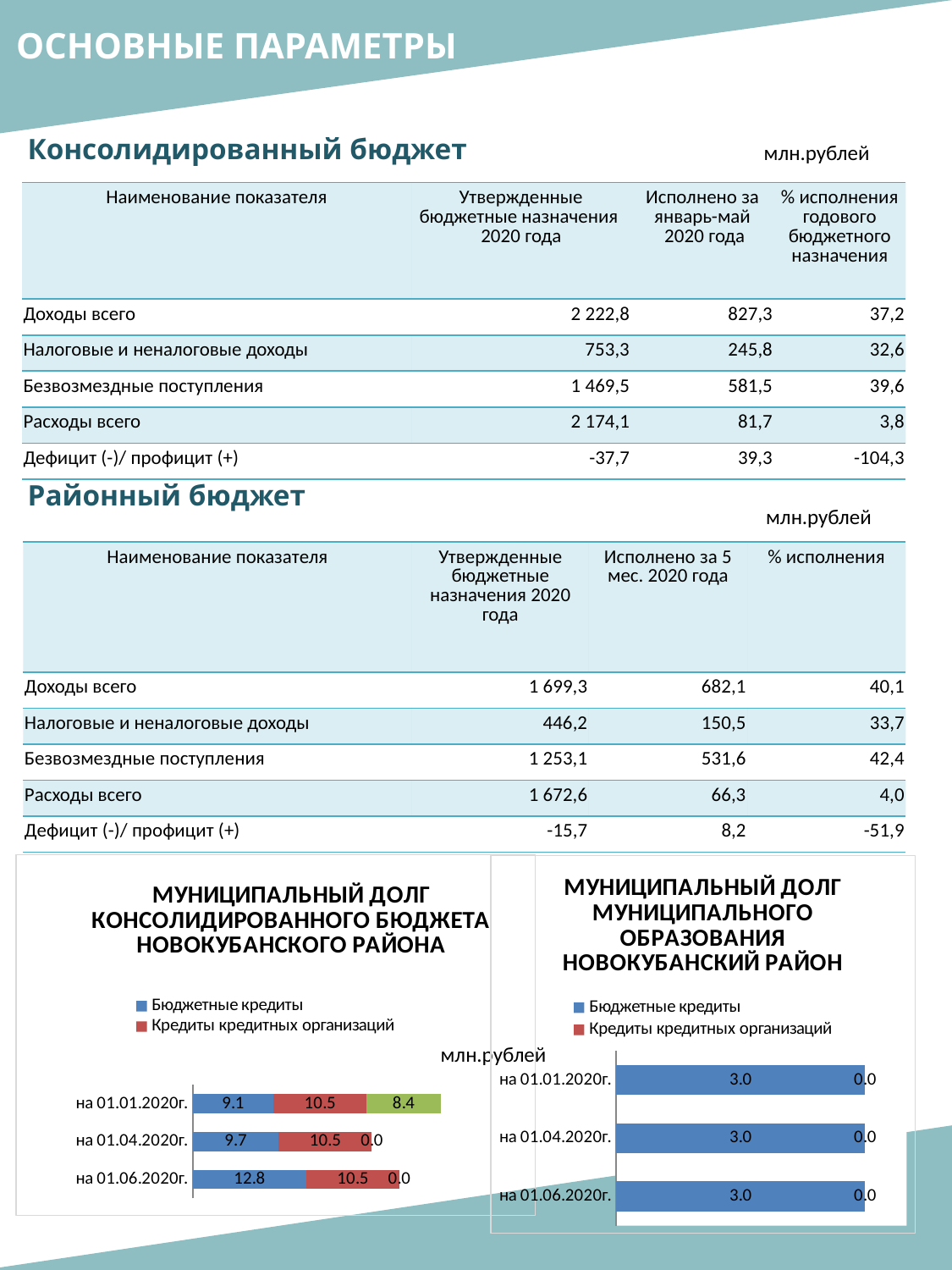
What kind of chart is the left chart titled 'МУНИЦИПАЛЬНЫЙ ДОЛГ КОНСОЛИДИРОВАННОГО БЮДЖЕТА НОВОКУБАНСКОГО РАЙОНА'? bar chart In the left chart (консолидированный бюджет), which is larger на 01.04.2020г.: Бюджетные кредиты or Кредиты кредитных организаций? Кредиты кредитных организаций In the right chart (муниципальное образование Новокубанский район), does the value of Бюджетные кредиты rise, fall or stay the same across the three dates? stays the same In the right chart (муниципальное образование Новокубанский район), what is the value of Кредиты кредитных организаций на 01.06.2020г.? 0.0 How many series does the legend of the left chart (консолидированный бюджет) list? 2 In the right chart (муниципальное образование Новокубанский район), what is the value of Бюджетные кредиты на 01.01.2020г.? 3.0 In the left chart (консолидированный бюджет), what is the value of Кредиты кредитных организаций на 01.04.2020г.? 10.5 How many dates (categories) are shown in the left chart (консолидированный бюджет)? 3 In the left chart (консолидированный бюджет), what is the value of Бюджетные кредиты на 01.06.2020г.? 12.8 In the left chart (консолидированный бюджет), what is the difference between Бюджетные кредиты на 01.06.2020г. and на 01.01.2020г.? 3.7 In the left chart (консолидированный бюджет), on which date is the value of Бюджетные кредиты the highest? на 01.06.2020г. In the left chart (консолидированный бюджет), what is the total of the stacked bar for на 01.01.2020г.? 28.0